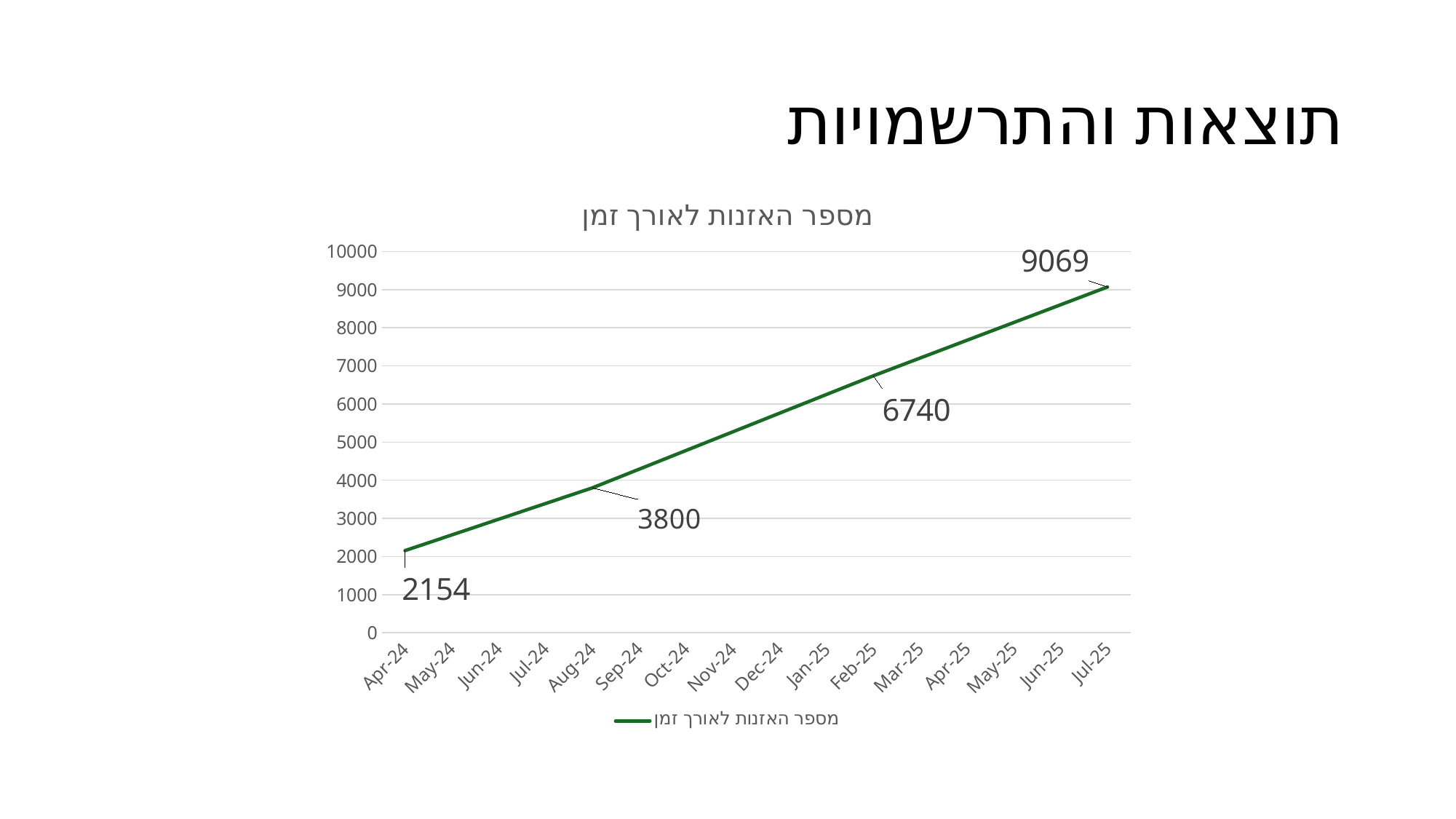
Is the value for Nov-24 greater or less than 4000? greater What kind of chart is shown on the slide? line chart Which month has the highest value? Jul-25 What is the value for Apr-24? 2154 What is the value for Feb-25? 6740 What is the difference between the values for Feb-25 and Aug-24? 2940 What is the value for Aug-24? 3800 What is the value for Jul-25? 9069 What is the difference between the values for Jul-25 and Apr-24? 6915 Which month has the lowest value? Apr-24 Do the values rise or fall from Apr-24 to Jul-25? rise How many months are shown on the x axis? 16